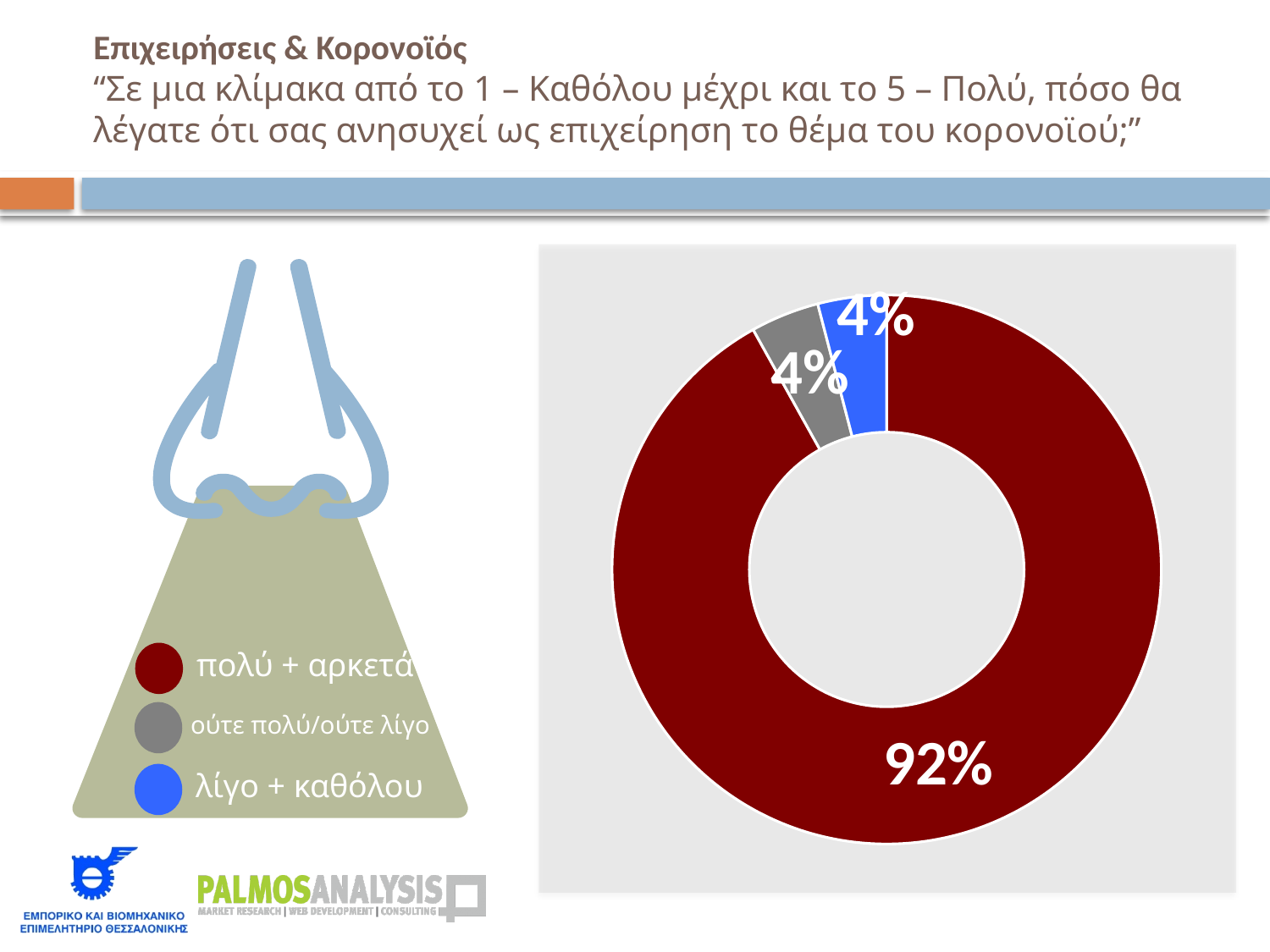
How many entries does the legend list? 3 Which legend entry is represented by the dark red colour? πολύ + αρκετά What is the combined share of the "ούτε πολύ/ούτε λίγο" and "λίγο + καθόλου" slices? 8% What percentage is shown for the "λίγο + καθόλου" slice? 4% What colour is the "λίγο + καθόλου" slice in the doughnut chart? blue What is the difference between the "πολύ + αρκετά" share and the "λίγο + καθόλου" share? 88% What kind of chart is shown on the slide? doughnut chart How many slices does the doughnut chart have? 3 Which is larger, the share for "πολύ + αρκετά" or the share for "ούτε πολύ/ούτε λίγο"? πολύ + αρκετά Which category has the largest share of the doughnut chart? πολύ + αρκετά What percentage is shown for the "πολύ + αρκετά" slice? 92% What percentage is shown for the "ούτε πολύ/ούτε λίγο" slice? 4%